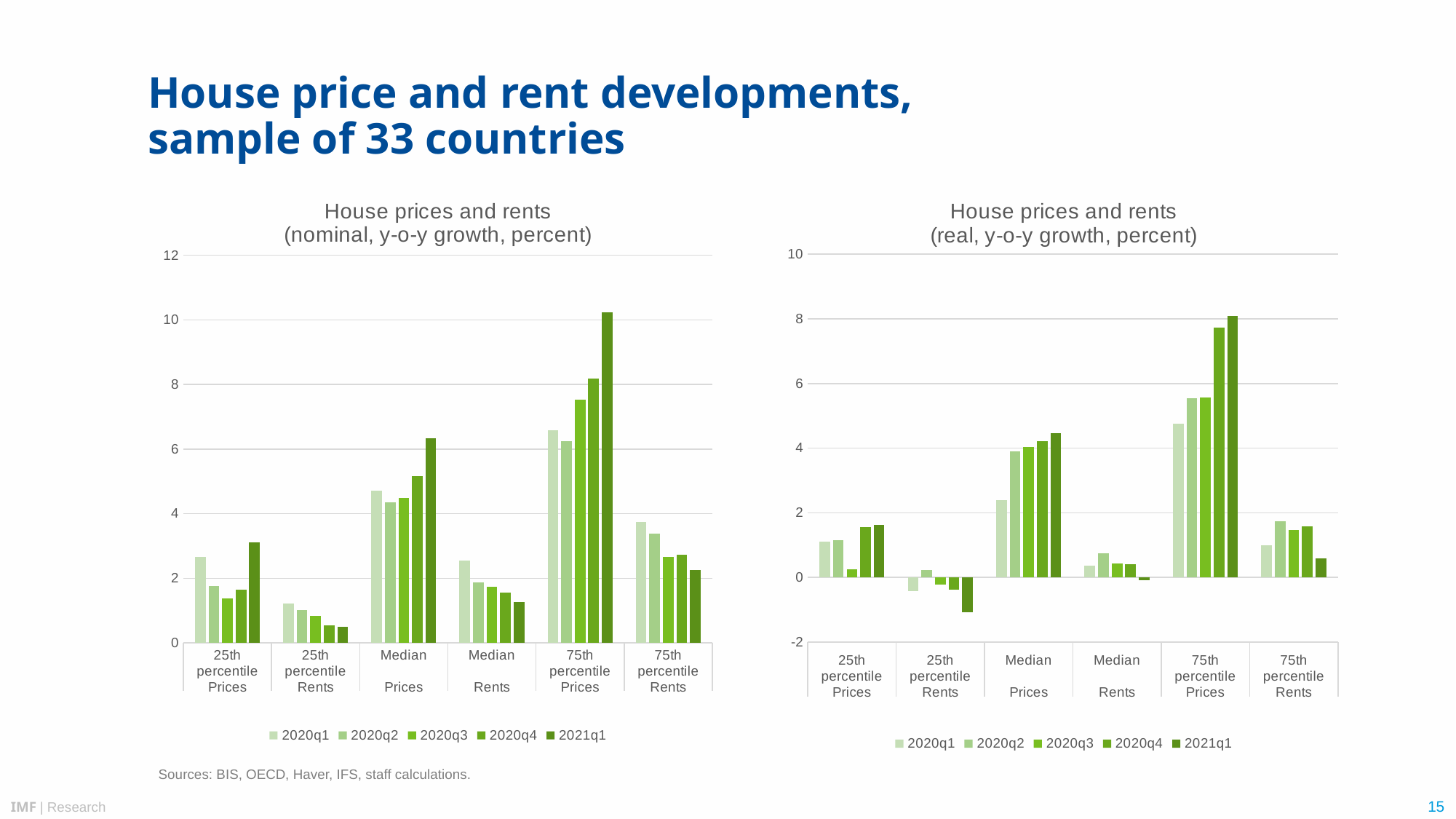
In the right chart (real), do the values for Median Prices rise or fall from 2020q1 to 2021q1? rise In the left chart (nominal), do the values for 25th percentile Rents rise or fall from 2020q1 to 2021q1? fall What kind of chart is the left chart, 'House prices and rents (nominal, y-o-y growth, percent)'? bar chart In the right chart (real), is the 2021q1 value for 75th percentile Rents greater or less than 1? less In the right chart (real), is the 2021q1 value for Median Prices greater or less than 4? greater In the left chart (nominal), which category and series has the highest bar? 75th percentile Prices, 2021q1 How many series does the legend of the right chart, 'House prices and rents (real, y-o-y growth, percent)', list? 5 In the left chart (nominal), which is larger for 2021q1: Median Prices or 75th percentile Rents? Median Prices In the left chart (nominal), is the 2021q1 value for 75th percentile Prices greater or less than 10? greater How many category groups are shown on the x axis of the left chart (nominal)? 6 In the right chart (real), which category and series has the lowest bar? 25th percentile Rents, 2021q1